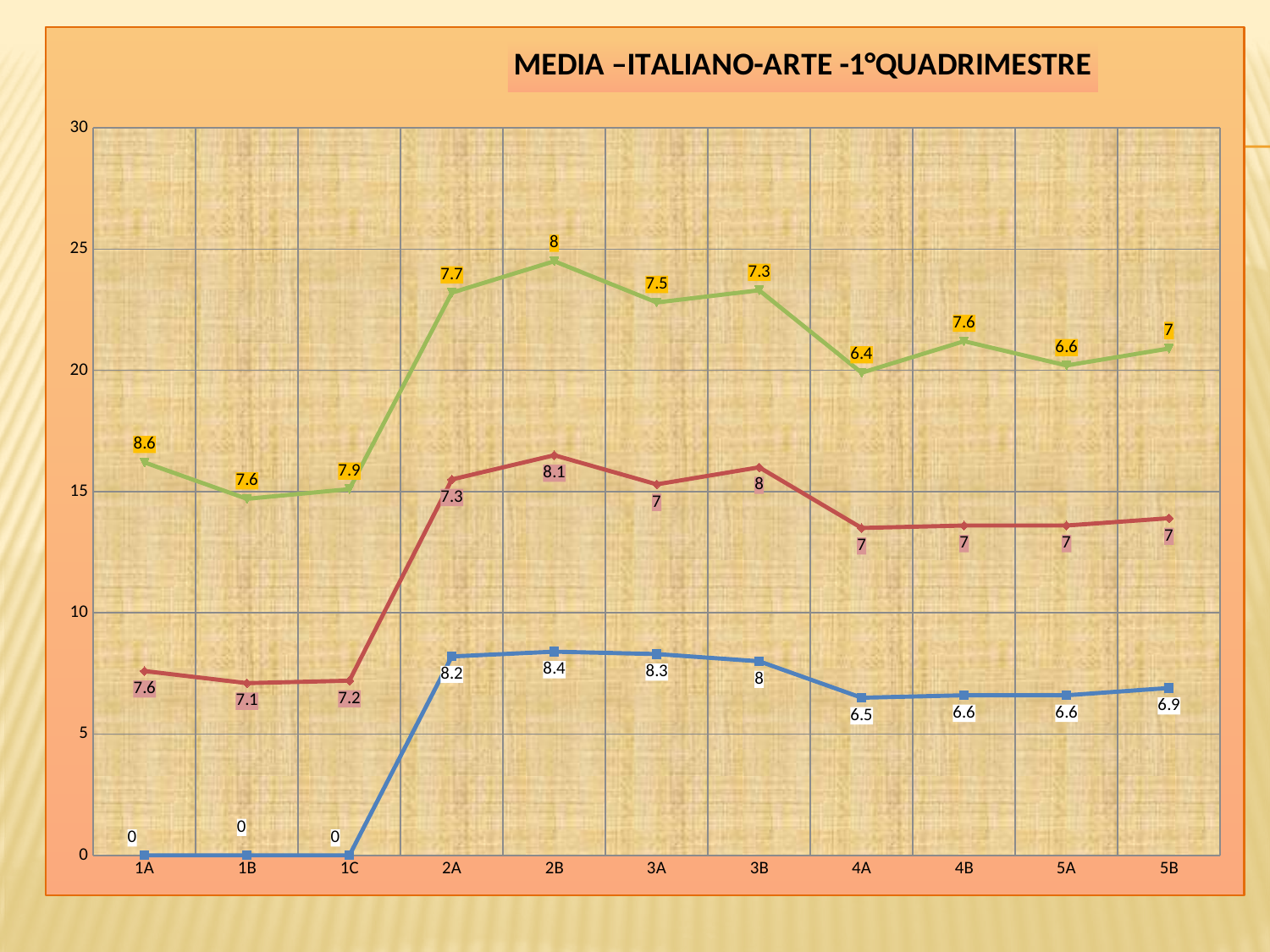
What is the value labelled on the blue line for 1C? 0 What is the difference between the blue line's labelled values for 2B and 4A? 1.9 Which category has the highest labelled value on the green line? 1A What is the value labelled on the green line for 1A? 8.6 On the green line, which is larger: the value for 1A or the value for 1B? 1A Does the blue line rise or fall from 1C to 2A? rise What kind of chart is shown on the slide? line chart What is the title of the chart? MEDIA –ITALIANO-ARTE -1°QUADRIMESTRE Which category has the lowest labelled value on the green line? 4A What is the value labelled on the blue line for 2B? 8.4 What is the value labelled on the red line for 2B? 8.1 How many categories are shown on the x axis? 11